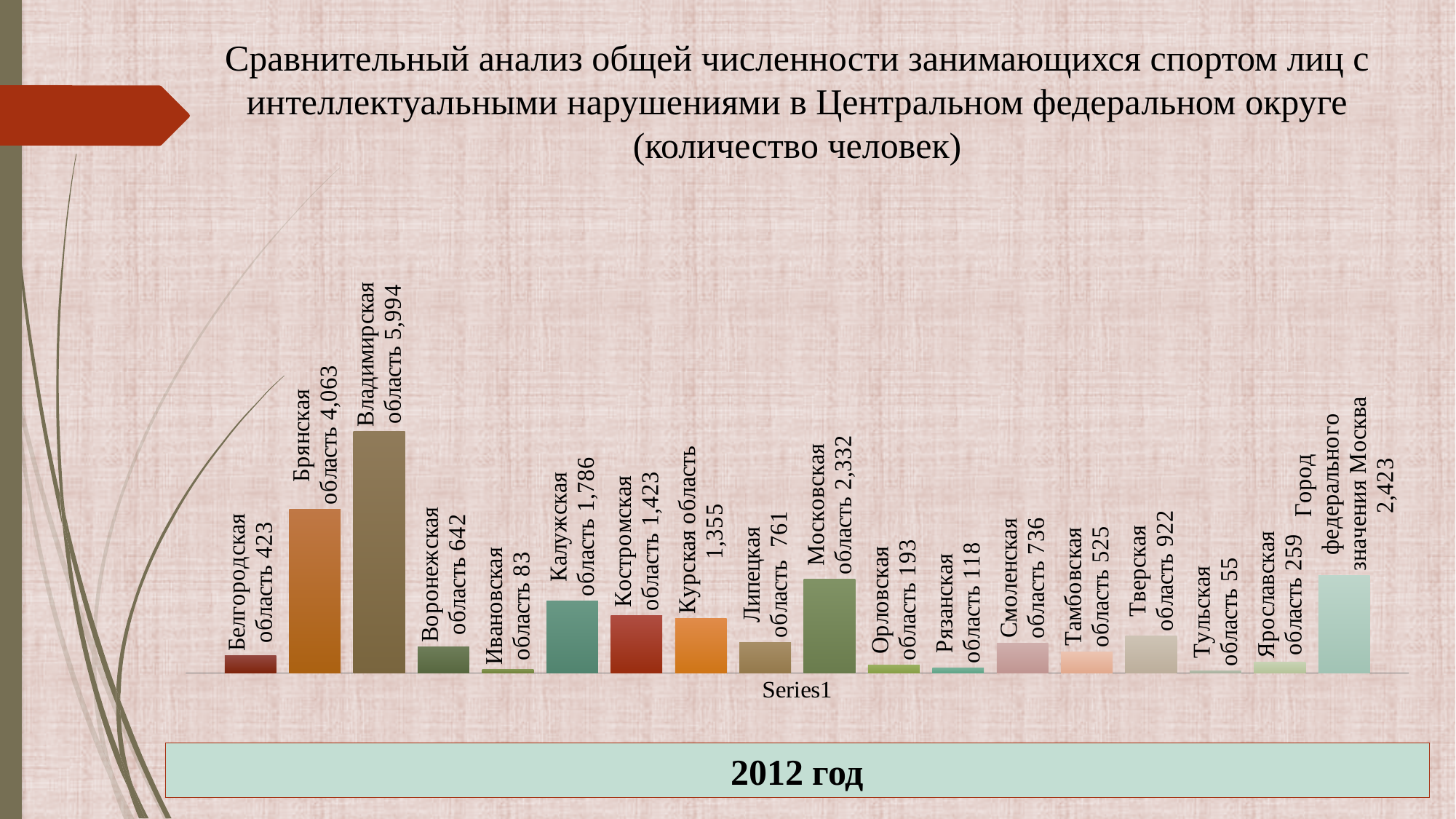
What is the value for Московская область? 2,332 What is the difference between the values for Калужская область and Костромская область? 363 What is the value for Владимирская область? 5,994 What is the value for Тульская область? 55 What is the difference between the values for Владимирская область and Брянская область? 1,931 What type of chart is shown on the slide? bar chart What is the value for Город федерального значения Москва? 2,423 What year is indicated in the box below the chart? 2012 год Which region has the highest value in the chart? Владимирская область Which region has the lowest value in the chart? Тульская область How many regions (bars) are shown in the chart? 18 Which has a larger value, Тверская область or Смоленская область? Тверская область